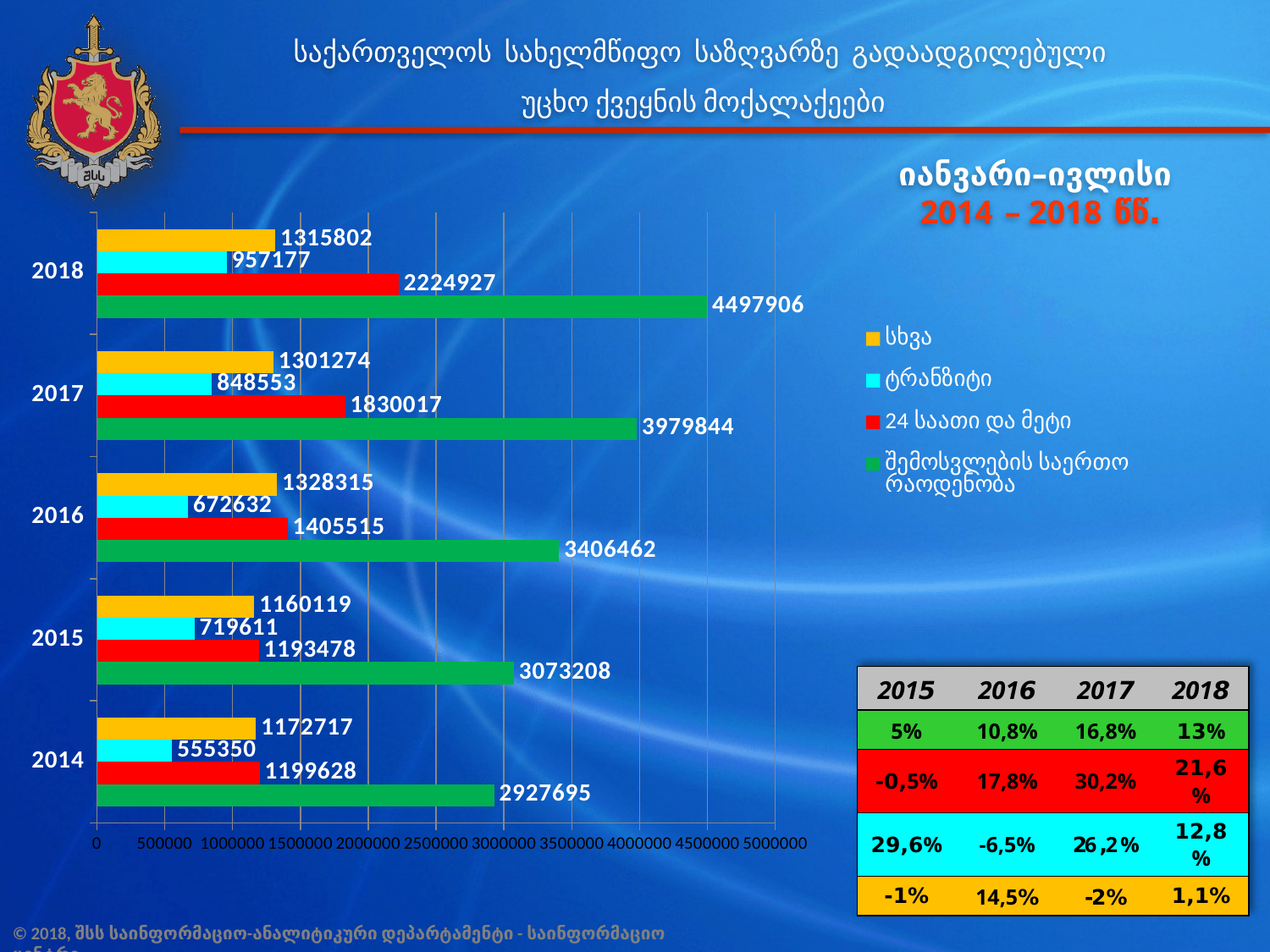
What is the difference between the green bar values for 2018 and 2017? 518062 How many series does the chart legend list? 4 What type of chart is shown on the slide? bar chart Does the green bar (შემოსვლების საერთო რაოდენობა) rise or fall from 2014 to 2018? rise What is the value of the yellow bar (სხვა) for 2015? 1160119 What is the value of the cyan bar (ტრანზიტი) for 2014? 555350 In which year is the cyan bar (ტრანზიტი) the lowest? 2014 What is the value of the red bar (24 საათი და მეტი) for 2016? 1405515 In which year is the green bar (შემოსვლების საერთო რაოდენობა) the highest? 2018 How many years (categories) are shown on the chart? 5 Which is larger: the red bar (24 საათი და მეტი) for 2017 or for 2016? 2017 What is the value of the green bar (შემოსვლების საერთო რაოდენობა) for 2018? 4497906